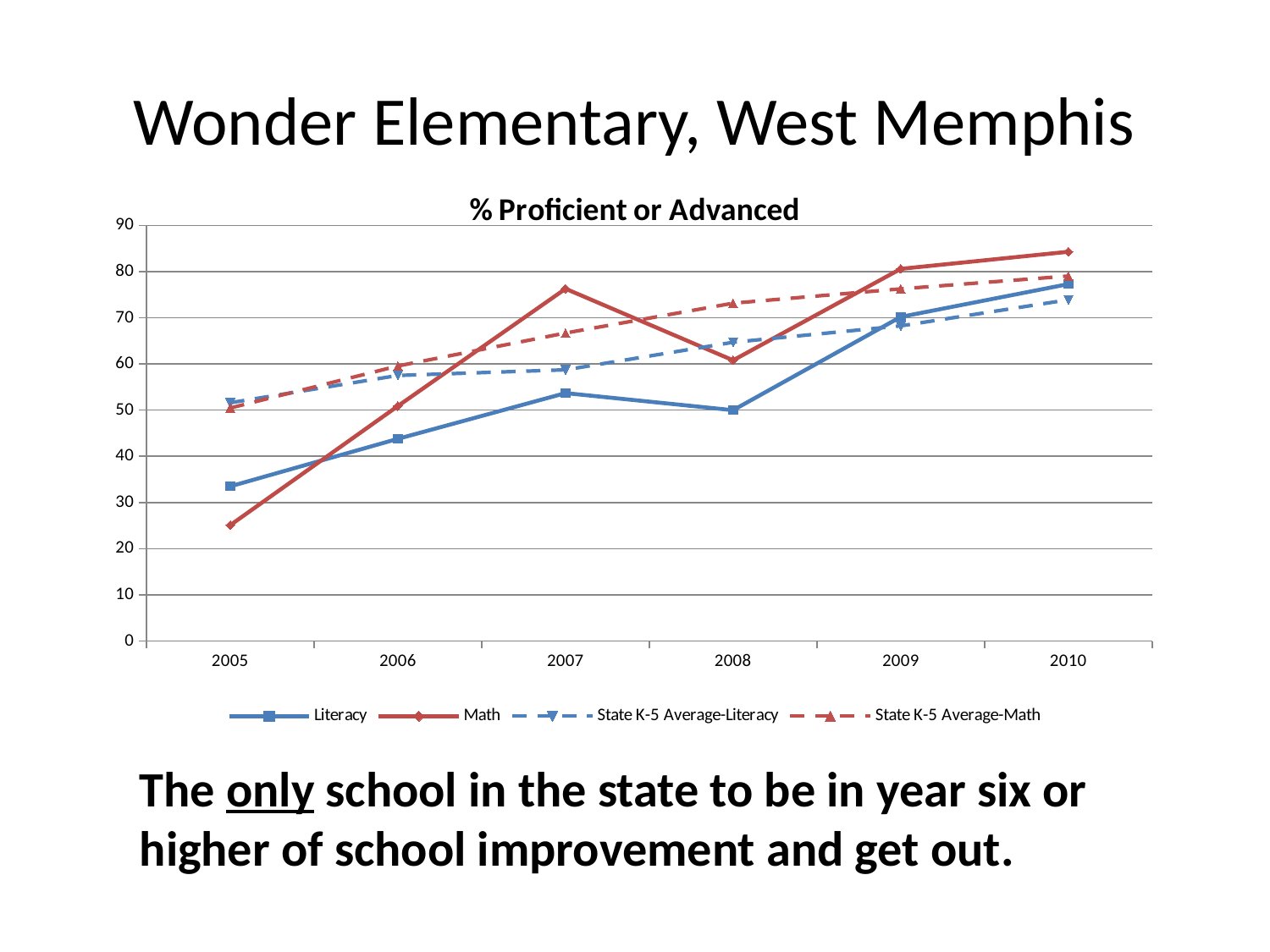
Is the Literacy value for 2010 greater or less than 70? greater What kind of chart is shown on the slide? line chart How many series does the legend list? 4 In which year is the Math series at its highest? 2010 In which year is the Literacy series at its lowest? 2005 Does the State K-5 Average-Math series rise or fall from 2005 to 2010? rise Is the Math value for 2005 greater or less than 30? less In which year is the Math series at its lowest? 2005 What is the title of the chart? % Proficient or Advanced In 2007, which is larger: Math or Literacy? Math In 2008, which is larger: Math or State K-5 Average-Math? State K-5 Average-Math How many years are plotted along the x axis? 6